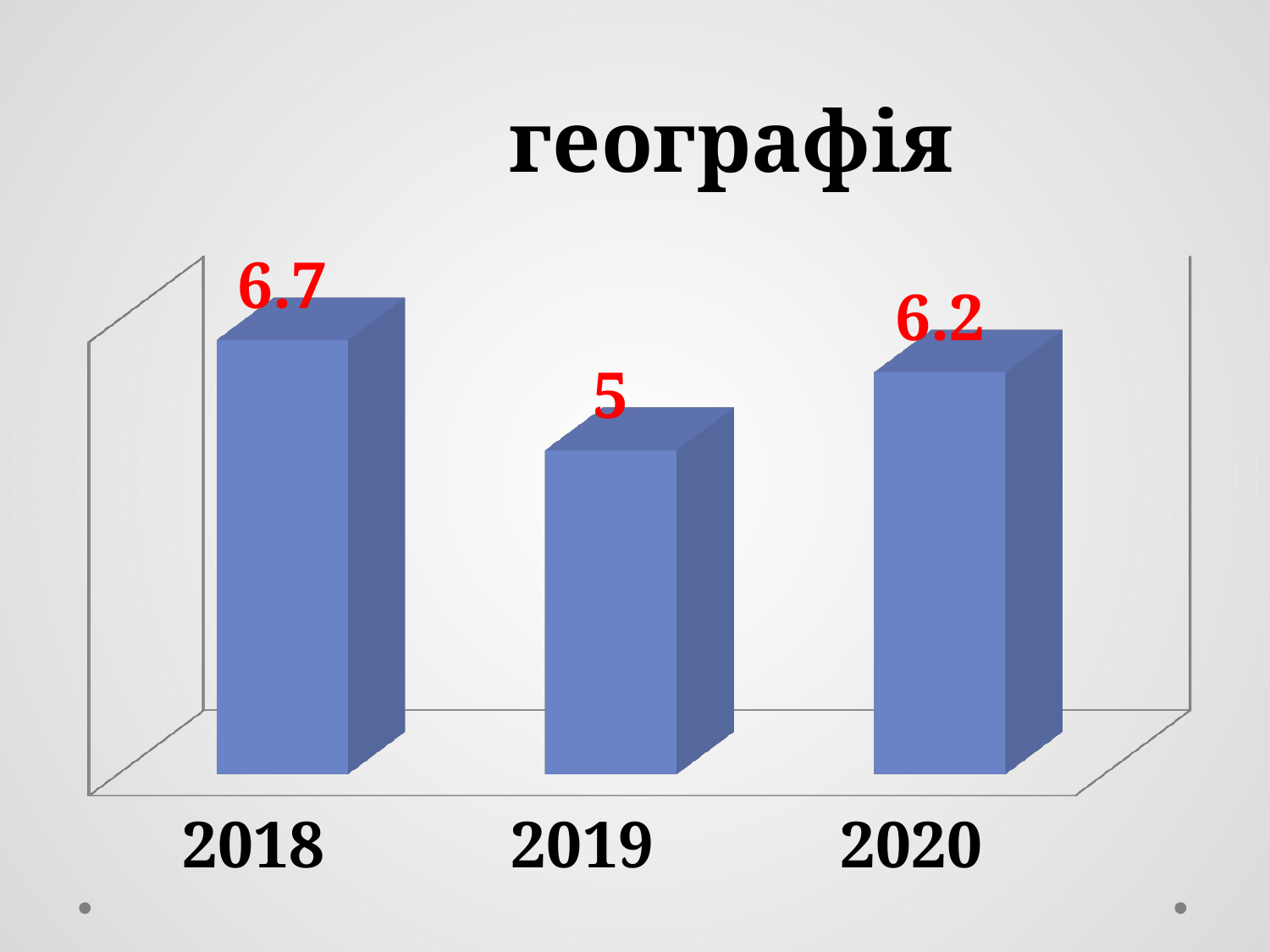
What kind of chart is shown on the slide? bar chart What is the difference between the values for 2018 and 2019? 1.7 Which year has the highest value? 2018 What is the title of the chart? географія What is the value for 2018? 6.7 What is the difference between the values for 2018 and 2020? 0.5 Which is larger, the value for 2019 or the value for 2020? 2020 What is the value for 2020? 6.2 Which year has the lowest value? 2019 How many years are shown on the chart? 3 What is the value for 2019? 5 Does the value rise or fall from 2018 to 2019? fall